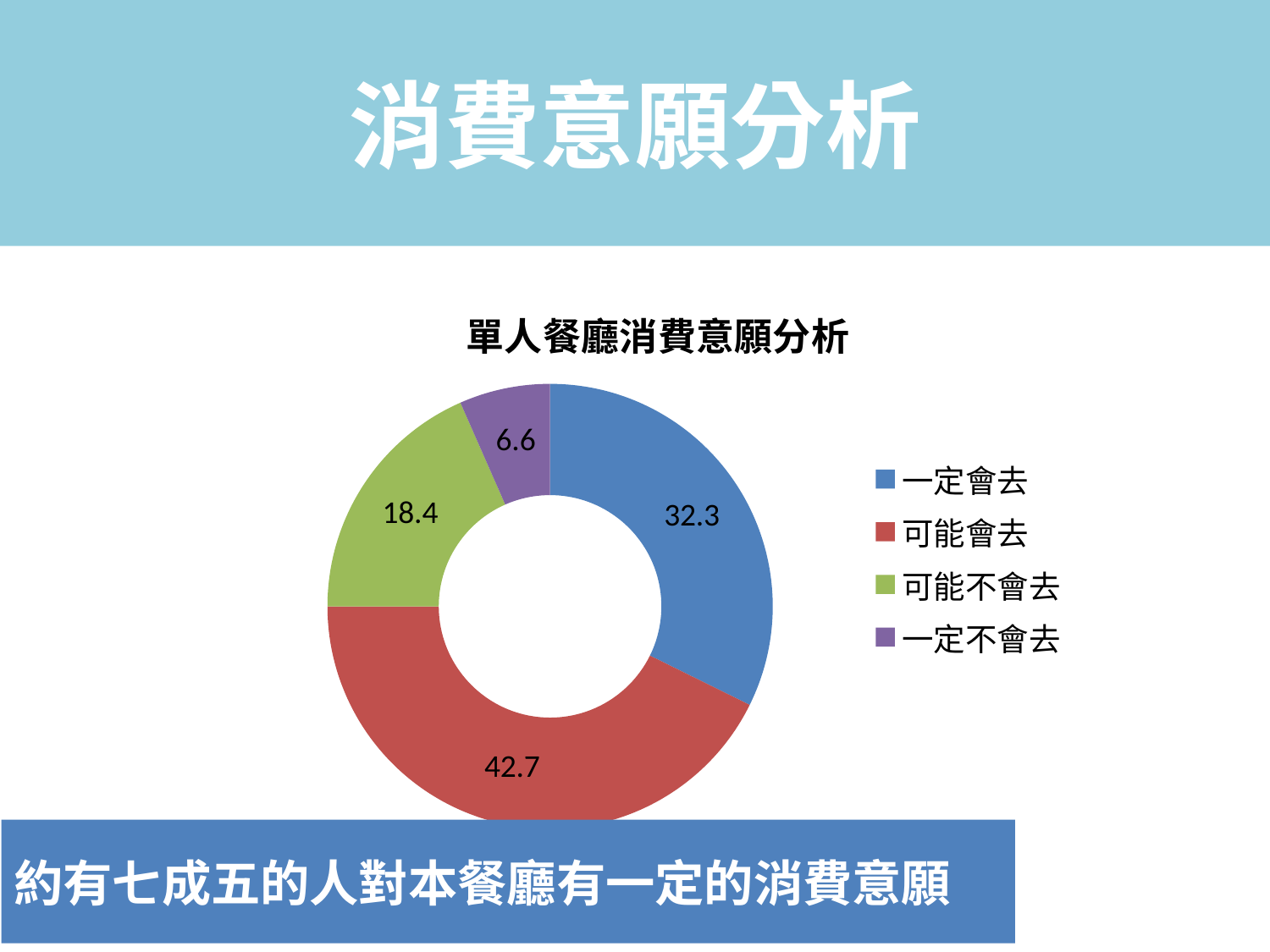
What value is shown for 一定不會去 in the chart? 6.6 What is the difference between the values for 可能會去 and 一定會去? 10.4 Which category has the smallest value in the chart? 一定不會去 What kind of chart is shown on the slide? Doughnut chart What value is shown for 一定會去 in the chart? 32.3 What value is shown for 可能會去 in the chart? 42.7 Which category has the largest value in the chart? 可能會去 What value is shown for 可能不會去 in the chart? 18.4 How many categories does the chart show? 4 What is the title of the chart? 單人餐廳消費意願分析 Which is larger, the value for 一定會去 or the value for 可能不會去? 一定會去 What is the difference between the values for 可能不會去 and 一定不會去? 11.8